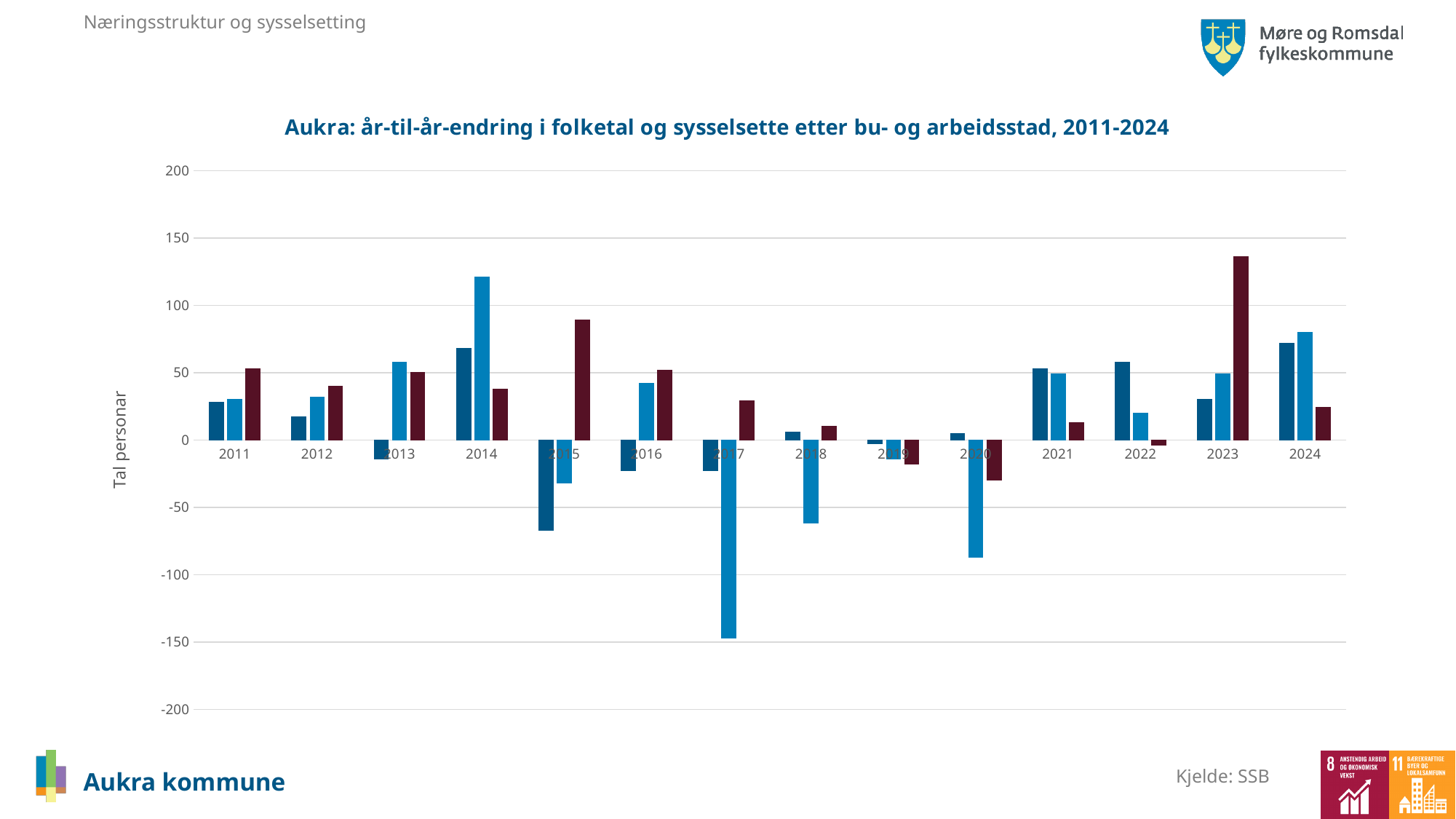
In which year is the light blue bar the lowest? 2017 For 2014, which is larger: the light blue bar or the dark red bar? the light blue bar Is the value of the dark red bar for 2023 greater or less than 100? greater Is the value of the light blue bar for 2020 greater or less than -50? less Is the value of the dark blue bar for 2015 greater or less than -50? less What is the title of the chart? Aukra: år-til-år-endring i folketal og sysselsette etter bu- og arbeidsstad, 2011-2024 In which year is the dark red bar the highest? 2023 What kind of chart is shown on the slide? bar chart What is the label on the vertical axis of the chart? Tal personar How many years are shown along the x axis of the chart? 14